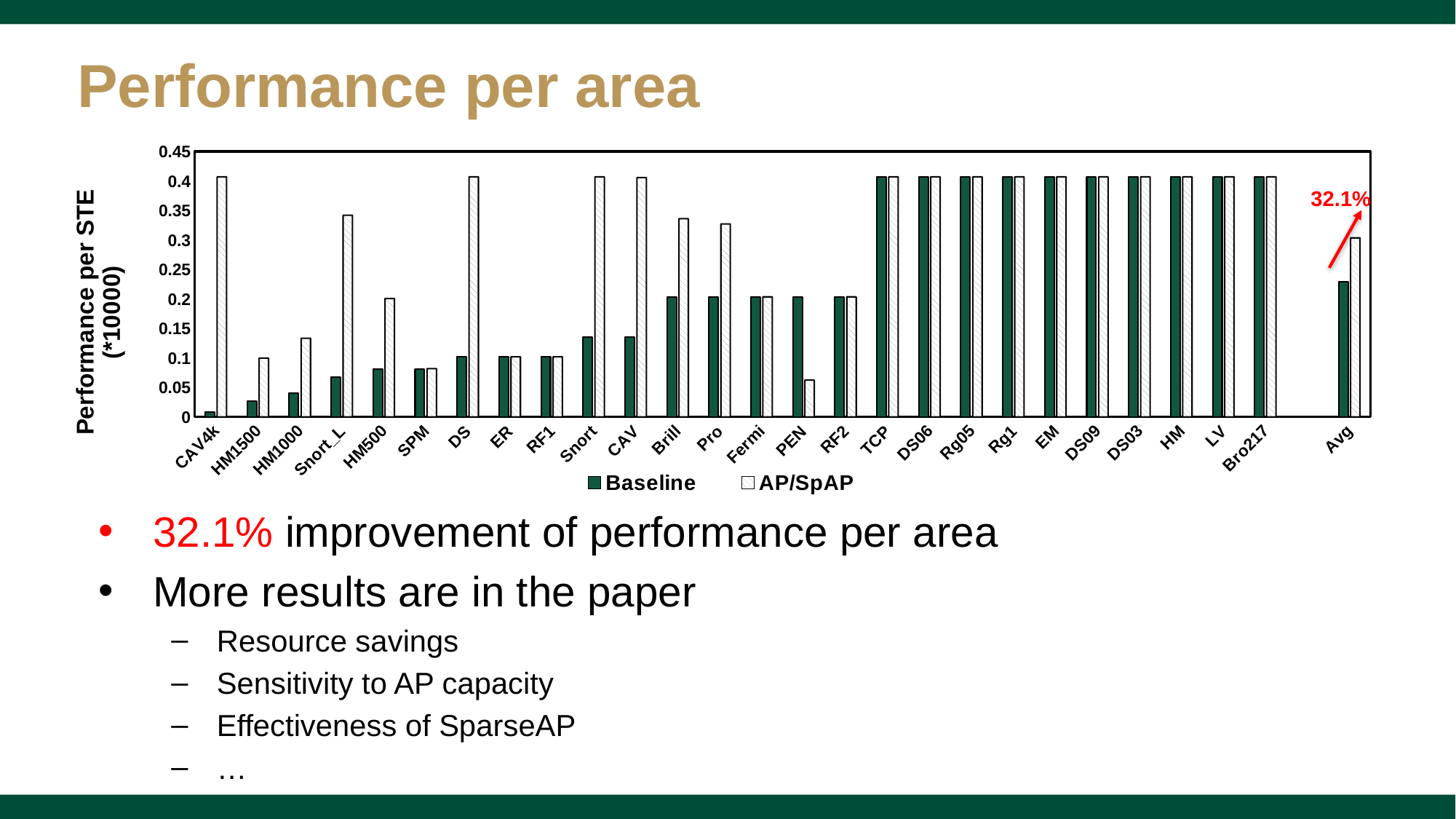
What are the two series named in the legend? Baseline and AP/SpAP Is the AP/SpAP value for PEN greater or less than 0.1? less Is the AP/SpAP value for Avg greater or less than 0.25? greater Which category has the lowest Baseline value? CAV4k For Avg, which series has the larger value, Baseline or AP/SpAP? AP/SpAP Is the Baseline value for CAV4k greater or less than 0.05? less For PEN, which series has the larger value, Baseline or AP/SpAP? Baseline What is the y-axis label of the chart? Performance per STE (*10000) What kind of chart is shown on the slide? bar chart What percentage is annotated above the Avg bars? 32.1% How many series does the legend list? 2